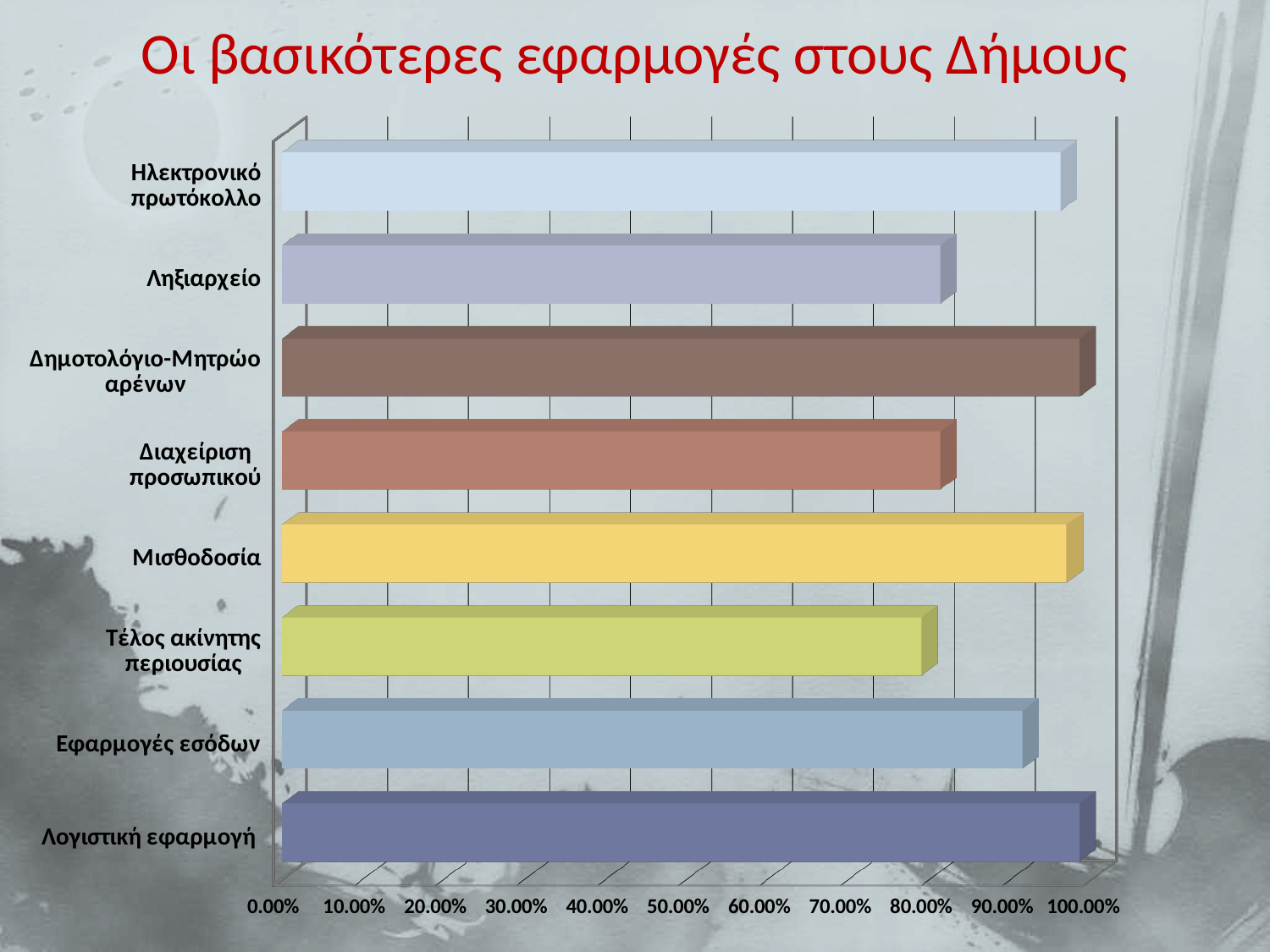
Is the value for Διαχείριση προσωπικού greater or less than 90.00%? less How many categories are plotted in the chart? 8 Which is larger, the value for Ηλεκτρονικό πρωτόκολλο or the value for Ληξιαρχείο? Ηλεκτρονικό πρωτόκολλο Is the value for Ληξιαρχείο greater or less than 90.00%? less What kind of chart is shown on the slide? Bar chart Is the value for Ηλεκτρονικό πρωτόκολλο greater or less than 90.00%? greater What is the highest value shown on the horizontal axis? 100.00% Which is larger, the value for Εφαρμογές εσόδων or the value for Διαχείριση προσωπικού? Εφαρμογές εσόδων Which is larger, the value for Μισθοδοσία or the value for Τέλος ακίνητης περιουσίας? Μισθοδοσία What is the title of the chart slide? Οι βασικότερες εφαρμογές στους Δήμους